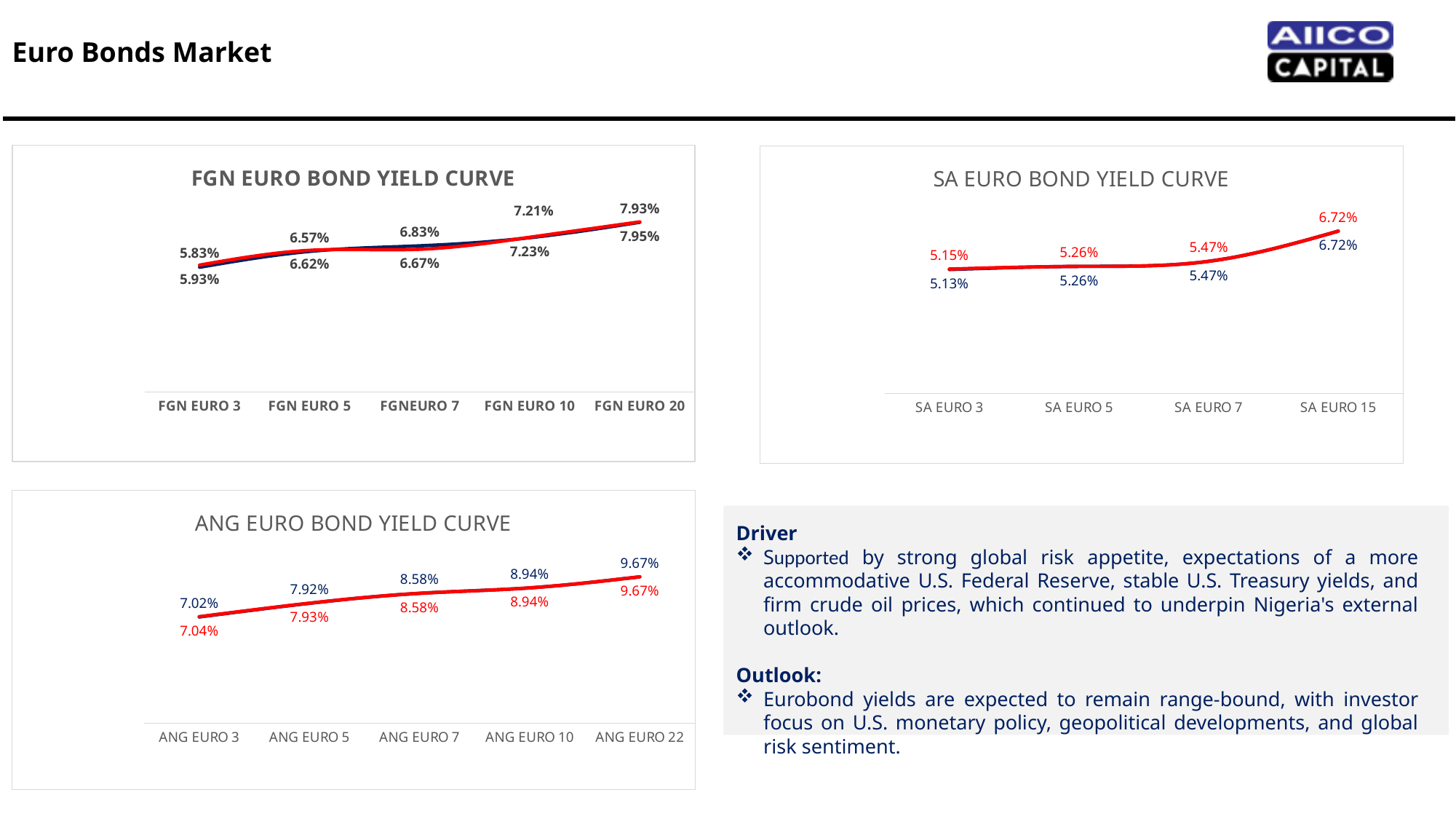
In the SA EURO BOND YIELD CURVE chart, which category has the lowest yield? SA EURO 3 In the FGN EURO BOND YIELD CURVE chart, which is larger: the yield at FGN EURO 20 or at FGN EURO 3? FGN EURO 20 How many categories are shown on the x axis of the FGN EURO BOND YIELD CURVE chart? 5 In the ANG EURO BOND YIELD CURVE chart, what is the blue-labelled value for ANG EURO 5? 7.92% In the ANG EURO BOND YIELD CURVE chart, do the yields rise or fall from ANG EURO 3 to ANG EURO 22? rise In the SA EURO BOND YIELD CURVE chart, what is the red-labelled value for SA EURO 3? 5.15% In the ANG EURO BOND YIELD CURVE chart, what is the red-labelled value for ANG EURO 3? 7.04% How many categories are shown on the x axis of the SA EURO BOND YIELD CURVE chart? 4 In the SA EURO BOND YIELD CURVE chart, what is the blue-labelled value for SA EURO 3? 5.13% What kind of chart is the FGN EURO BOND YIELD CURVE? line chart In the ANG EURO BOND YIELD CURVE chart, which category has the highest yield? ANG EURO 22 In the SA EURO BOND YIELD CURVE chart, what is the difference between the red-labelled values for SA EURO 15 and SA EURO 3? 1.57%